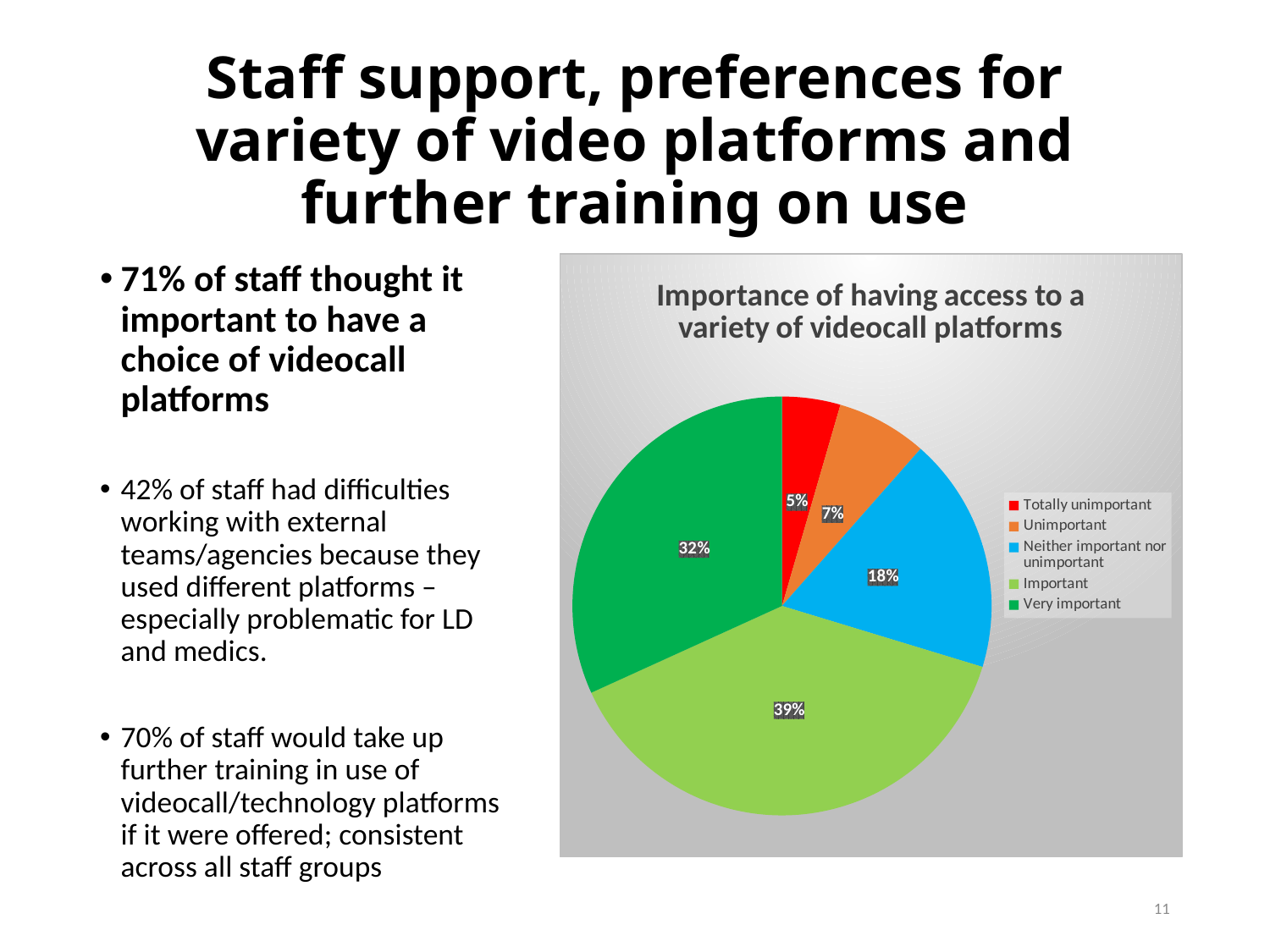
What kind of chart is shown on the slide? pie chart How many categories does the legend list? 5 What share of the pie is labelled 'Neither important nor unimportant'? 18% What share of the pie is labelled 'Very important'? 32% What share of the pie is labelled 'Important'? 39% Which category has the largest slice of the pie? Important What is the title of the chart? Importance of having access to a variety of videocall platforms Which slice is larger, 'Neither important nor unimportant' or 'Unimportant'? Neither important nor unimportant Which category has the smallest slice of the pie? Totally unimportant What is the difference in percentage points between the 'Important' and 'Very important' slices? 7